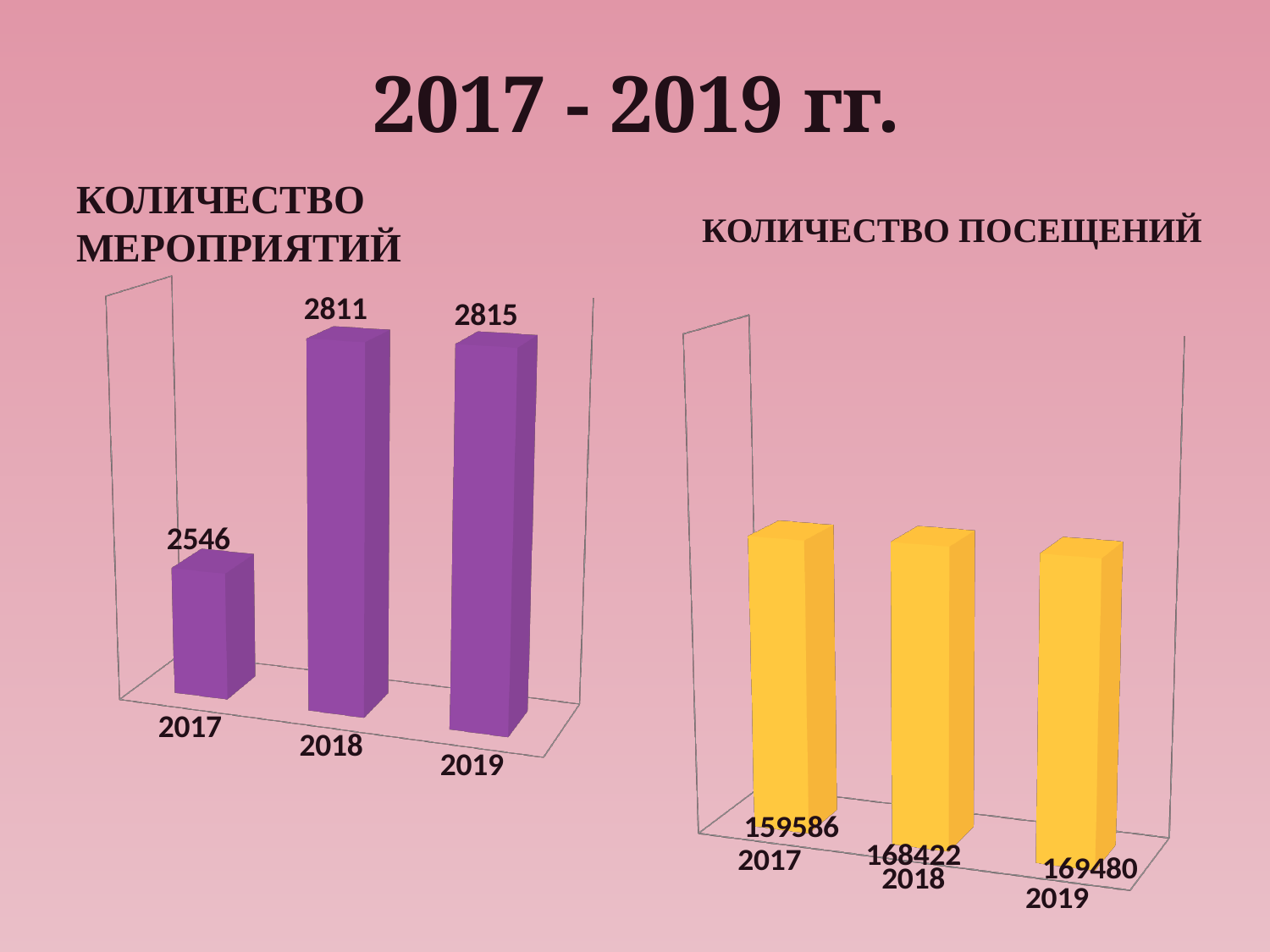
In the chart titled КОЛИЧЕСТВО МЕРОПРИЯТИЙ, what is the difference between the values for 2018 and 2017? 265 In the chart titled КОЛИЧЕСТВО ПОСЕЩЕНИЙ, what is the value for 2017? 159586 In the chart titled КОЛИЧЕСТВО МЕРОПРИЯТИЙ, what is the value for 2019? 2815 In the chart titled КОЛИЧЕСТВО ПОСЕЩЕНИЙ, what is the value for 2018? 168422 In the chart titled КОЛИЧЕСТВО МЕРОПРИЯТИЙ, which year has the highest value? 2019 In the chart titled КОЛИЧЕСТВО МЕРОПРИЯТИЙ, what is the value for 2018? 2811 In the chart titled КОЛИЧЕСТВО ПОСЕЩЕНИЙ, what is the difference between the values for 2019 and 2018? 1058 In the chart titled КОЛИЧЕСТВО МЕРОПРИЯТИЙ, which year has the lowest value? 2017 In the chart titled КОЛИЧЕСТВО ПОСЕЩЕНИЙ, what is the value for 2019? 169480 In the chart titled КОЛИЧЕСТВО МЕРОПРИЯТИЙ, what is the value for 2017? 2546 In the chart titled КОЛИЧЕСТВО МЕРОПРИЯТИЙ, how many years are shown? 3 What type of chart is the chart titled КОЛИЧЕСТВО ПОСЕЩЕНИЙ? Bar chart